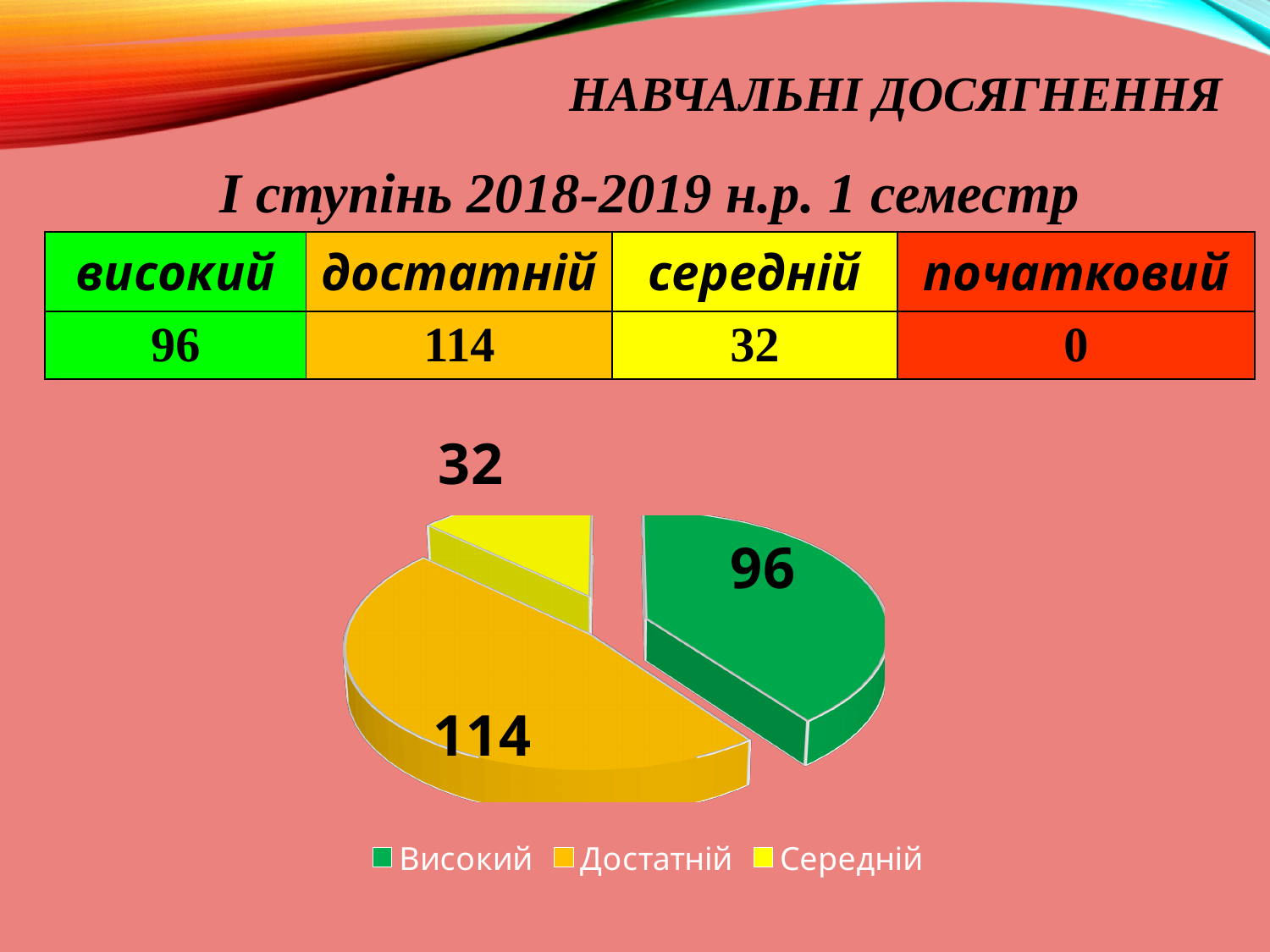
Which category has the smallest slice in the pie chart? Середній How many slices does the pie chart have? 3 What is the difference between the Високий and Середній values in the pie chart? 64 What is the difference between the Достатній and Високий values in the pie chart? 18 Which category has the largest slice in the pie chart? Достатній What type of chart is shown on the slide? pie chart What is the value of the Достатній slice in the pie chart? 114 What colour is the Достатній slice in the pie chart? orange What is the value of the Високий slice in the pie chart? 96 Which is larger in the pie chart, Високий or Середній? Високий How many entries does the pie chart legend list? 3 What is the value of the Середній slice in the pie chart? 32